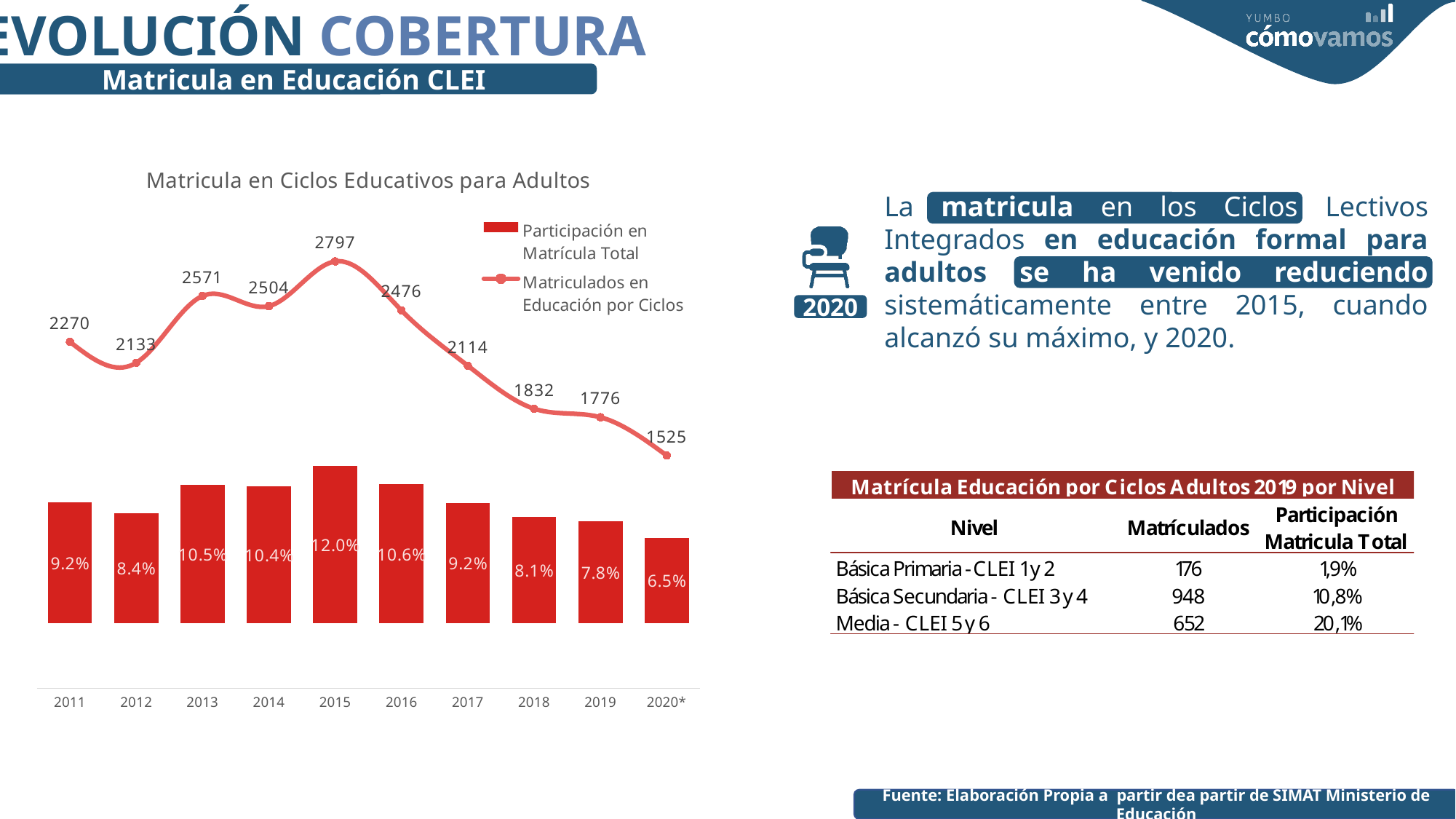
What is the value of Matriculados en Educación por Ciclos for 2015? 2797 What is the title of the chart? Matricula en Ciclos Educativos para Adultos What is the difference in Matriculados en Educación por Ciclos between 2015 and 2020*? 1272 How many series does the chart legend list? 2 Which year has more Matriculados en Educación por Ciclos, 2013 or 2016? 2013 Do the values of Matriculados en Educación por Ciclos rise or fall from 2015 to 2020*? Fall How many years are shown on the x axis of the chart? 10 Which year has the lowest Participación en Matrícula Total? 2020* What is the value of Matriculados en Educación por Ciclos for 2011? 2270 What kind of chart is used to show Participación en Matrícula Total? Bar chart What is the Participación en Matrícula Total for 2020*? 6.5% Which year has the highest value of Matriculados en Educación por Ciclos? 2015